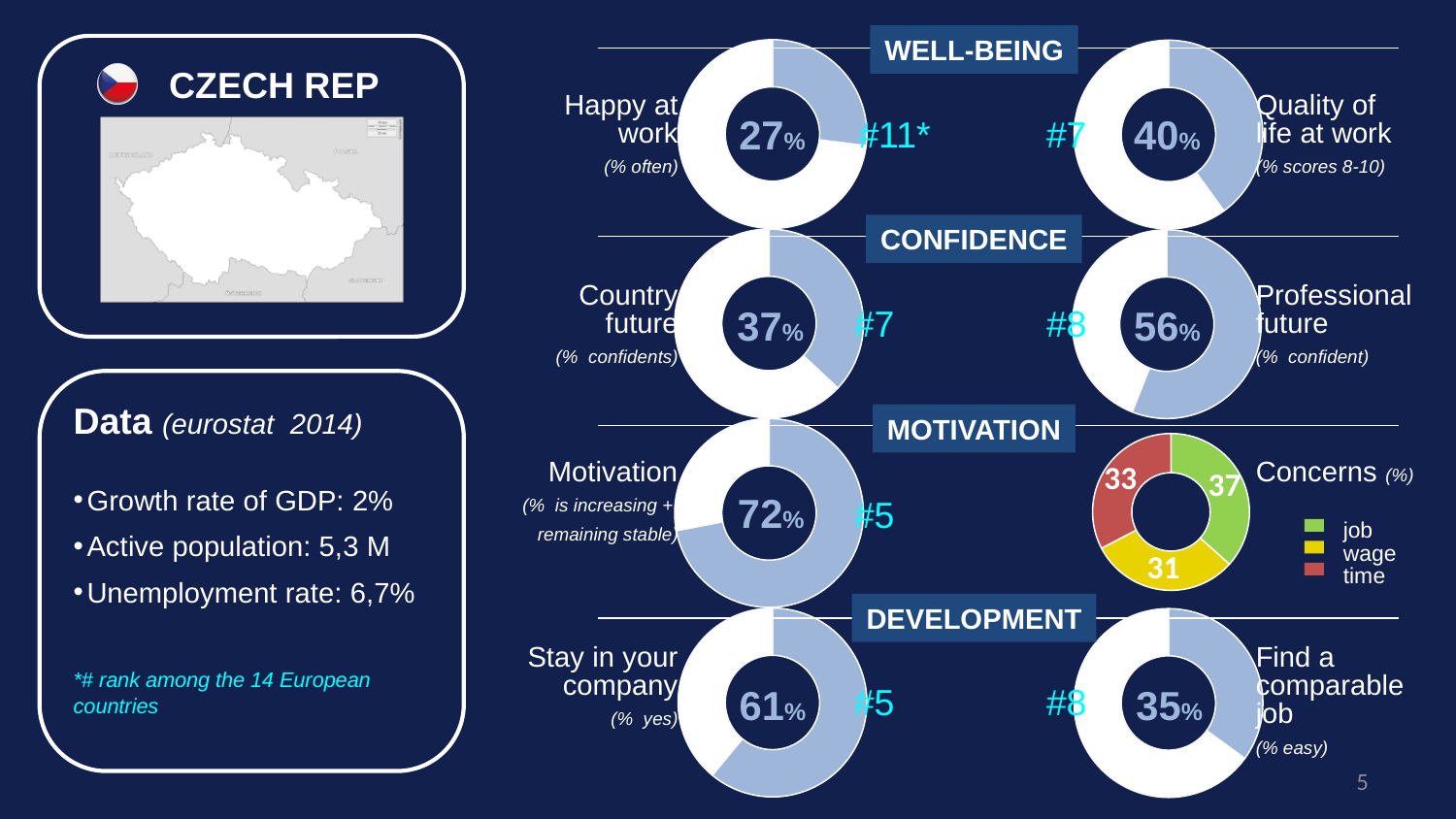
On the 'Concerns' donut chart, what is the value for wage? 31 On the 'Quality of life at work' donut chart, what percentage is shown? 40% On the 'Concerns' donut chart, which category has the lowest value? wage What is the difference between the percentage on the 'Stay in your company' chart and the percentage on the 'Find a comparable job' chart? 26% On the 'Concerns' donut chart, which category has the highest value? job On the 'Happy at work' donut chart, what percentage is shown in the centre? 27% Which is larger: the percentage on the 'Country future' chart or the percentage on the 'Professional future' chart? Professional future On the 'Concerns' donut chart, what is the difference between the job value and the time value? 4 On the 'Concerns' donut chart, what colour represents time? red On the 'Professional future' donut chart, what percentage is shown? 56% On the 'Motivation' donut chart, what percentage is shown? 72% On the 'Concerns' donut chart, how many categories does the legend list? 3